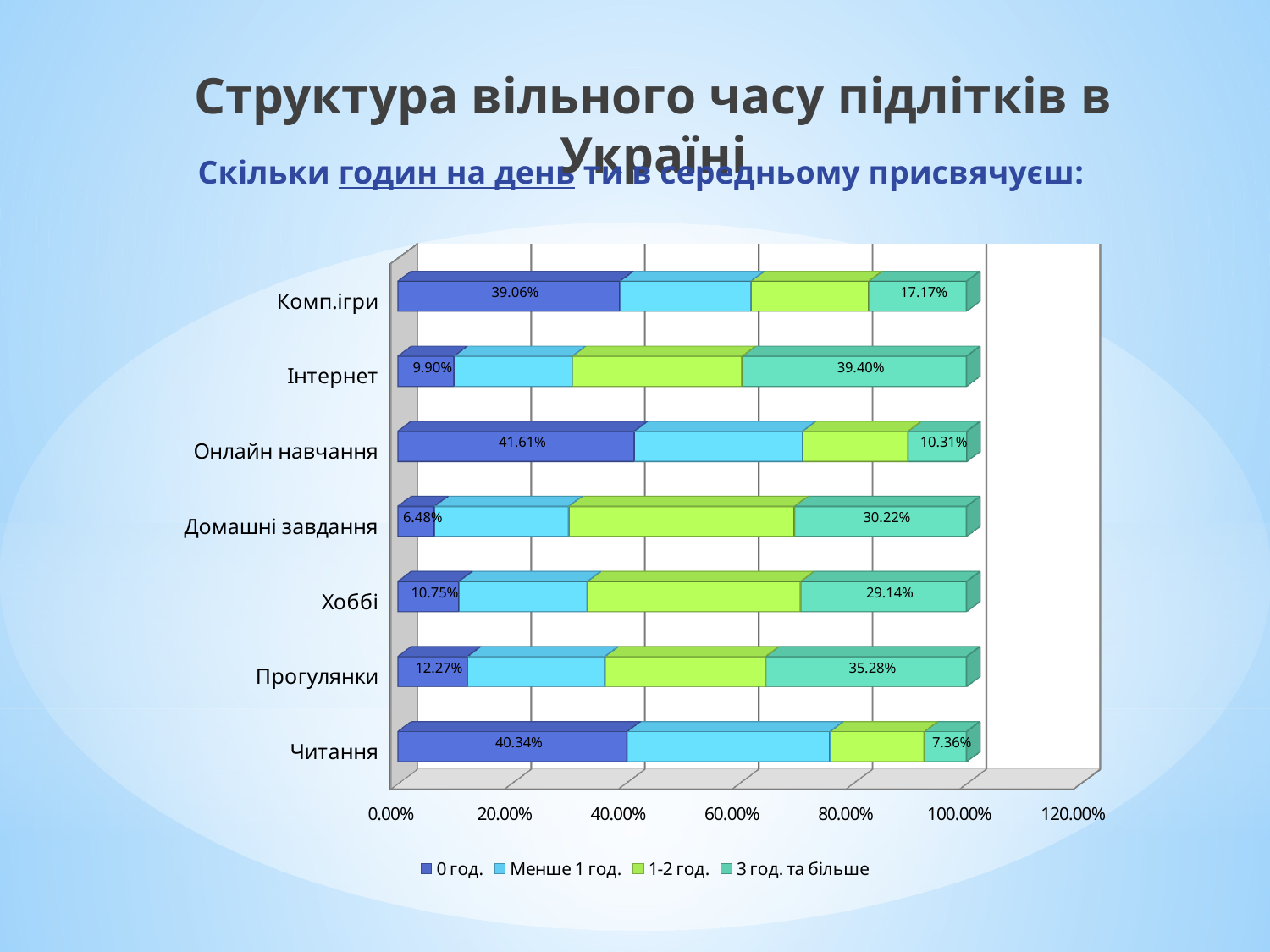
What is the value for "3 год. та більше" for Читання? 7.36% What is the value for "0 год." for Комп.ігри? 39.06% What is the value for "3 год. та більше" for Інтернет? 39.40% Which category has the lowest value for "3 год. та більше"? Читання Is the "1-2 год." value for Домашні завдання greater or less than 20%? greater How many series does the legend list? 4 How many categories are shown on the chart? 7 Which is larger: the "3 год. та більше" value for Прогулянки or for Хоббі? Прогулянки What is the difference between the "0 год." values for Онлайн навчання and Домашні завдання? 35.13% What is the value for "0 год." for Домашні завдання? 6.48% What kind of chart is shown on the slide? Stacked bar chart Which category has the highest value for "0 год."? Онлайн навчання